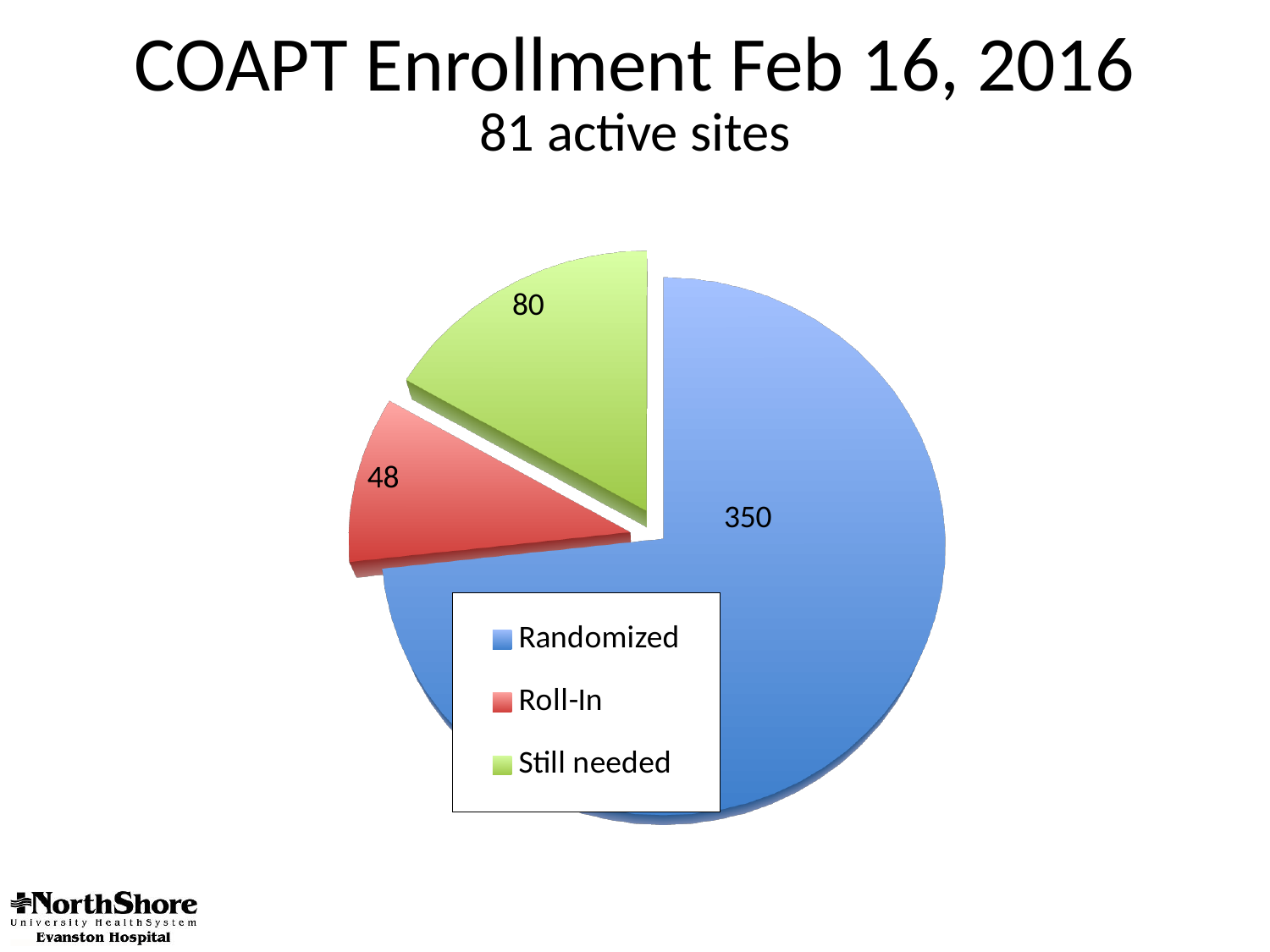
Which category has the smallest slice of the pie? Roll-In Which is larger, Roll-In or Still needed? Still needed What is the value for Roll-In? 48 How many categories does the pie chart have? 3 What type of chart is shown on the slide? pie chart What is the total of all slices in the pie chart? 478 What is the value for Randomized? 350 What is the difference between the Still needed value and the Roll-In value? 32 What is the difference between the Randomized value and the Still needed value? 270 Which category has the largest slice of the pie? Randomized What is the value for Still needed? 80 What colour is the Still needed slice? green